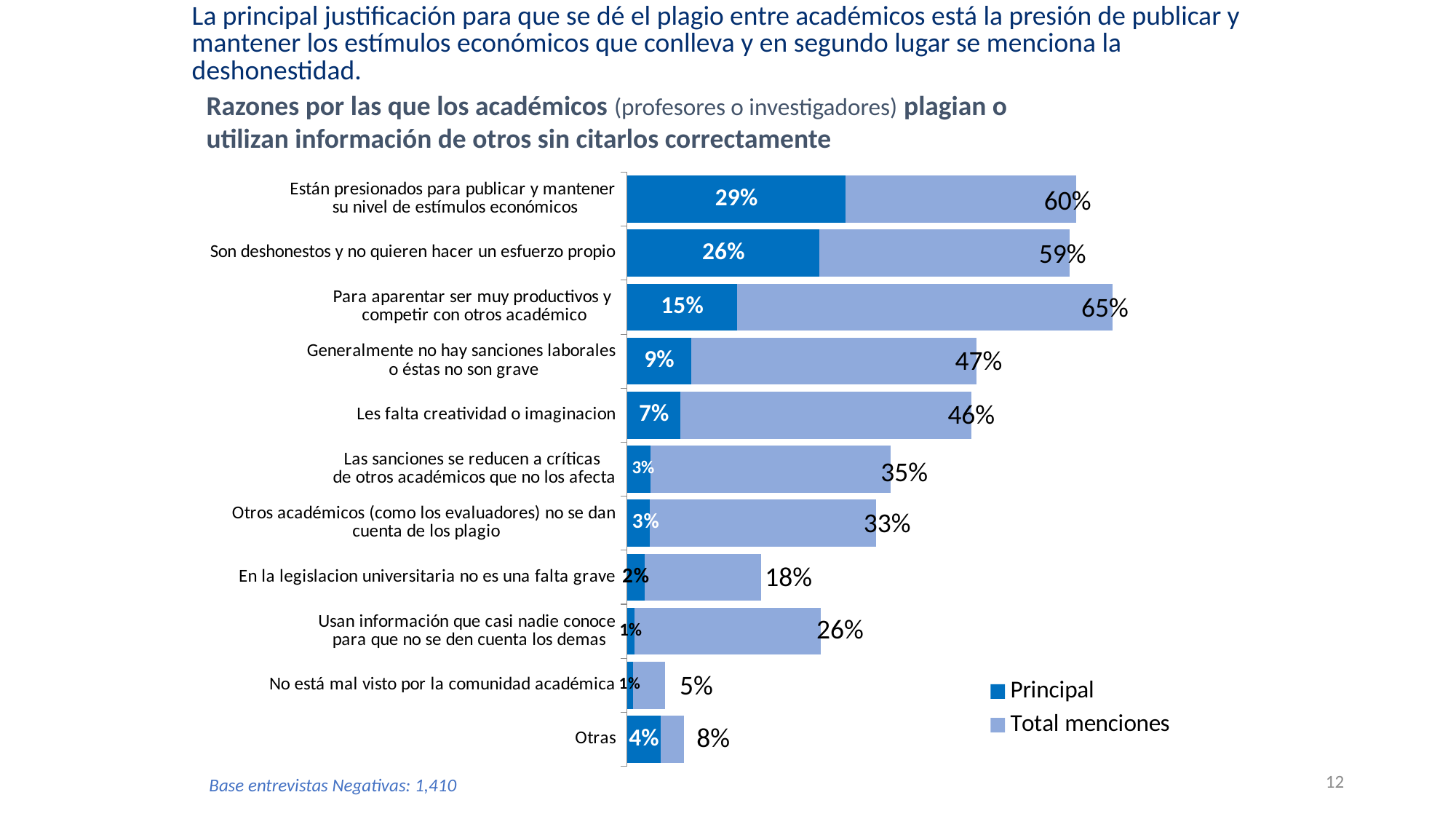
Which is larger: the Total menciones value for "En la legislacion universitaria no es una falta grave" or for "Usan información que casi nadie conoce para que no se den cuenta los demas"? Usan información que casi nadie conoce para que no se den cuenta los demas Which category has the highest Total menciones value? Para aparentar ser muy productivos y competir con otros académico What is the Total menciones value for "Para aparentar ser muy productivos y competir con otros académico"? 65% What kind of chart is shown on the slide? Bar chart What is the Principal value for "Otras"? 4% Which category has the highest Principal value? Están presionados para publicar y mantener su nivel de estímulos económicos What is the difference between the Total menciones and Principal values for "Son deshonestos y no quieren hacer un esfuerzo propio"? 33% Which category has the lowest Total menciones value? No está mal visto por la comunidad académica How many series does the legend list? 2 What is the Principal value for "Están presionados para publicar y mantener su nivel de estímulos económicos"? 29% What is the Total menciones value for "Les falta creatividad o imaginacion"? 46% How many categories (reasons) are shown in the chart? 11